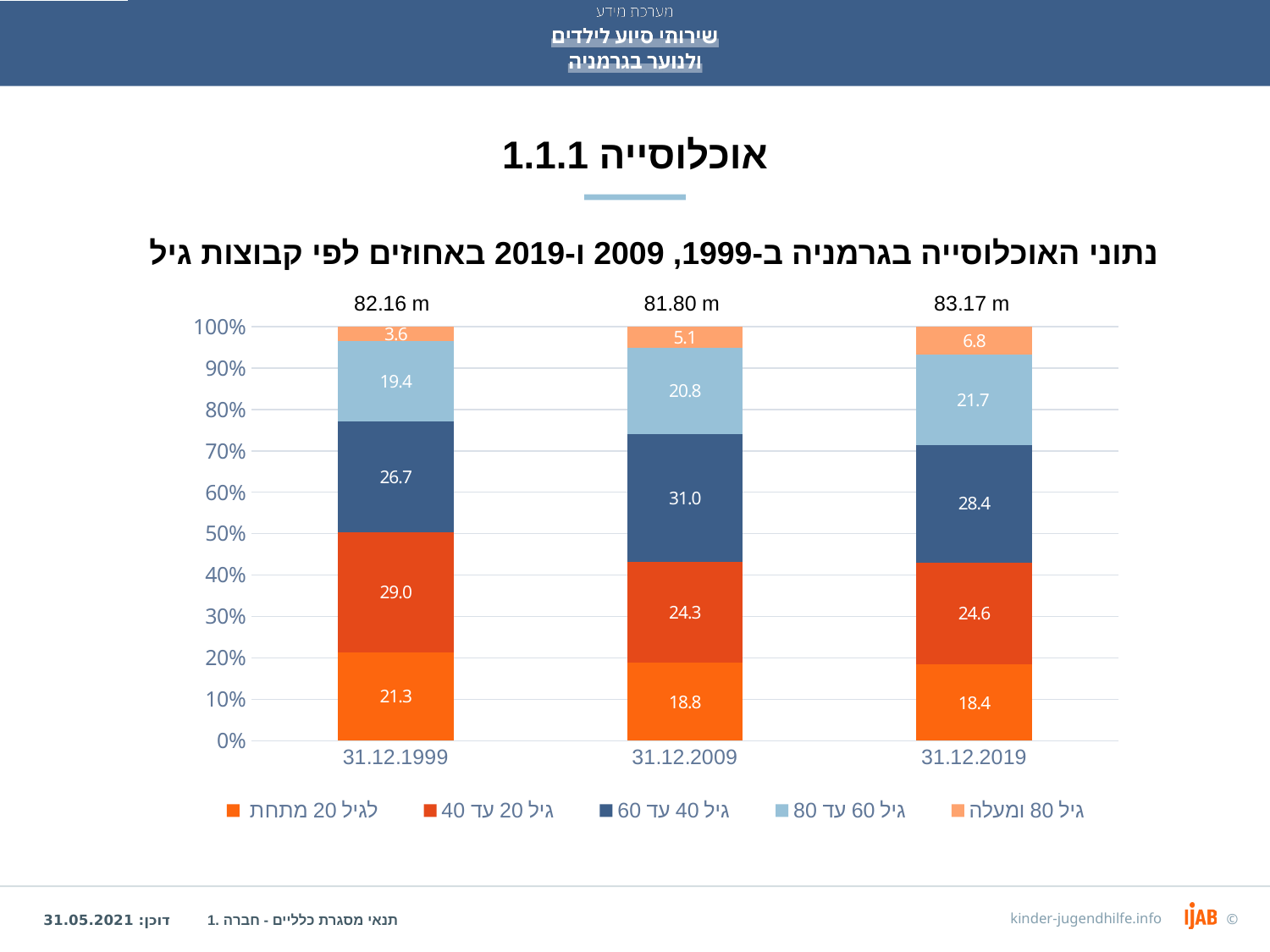
What total population figure is printed above the 31.12.2019 bar? 83.17 m Does the value for 'גיל 60 עד 80' rise or fall from 31.12.1999 to 31.12.2019? rise What is the value for the 'גיל 40 עד 60' series at 31.12.2009? 31.0 At which date is the value for 'גיל 80 ומעלה' the highest? 31.12.2019 What is the value for the 'מתחת לגיל 20' series at 31.12.1999? 21.3 How many dates (categories) are shown on the x axis? 3 How many series does the legend list? 5 What type of chart is shown on the slide? stacked bar chart What is the difference between the 'גיל 20 עד 40' values at 31.12.1999 and 31.12.2009? 4.7 What is the value for the 'גיל 80 ומעלה' series at 31.12.2019? 6.8 Which is larger at 31.12.2019: the value for 'גיל 40 עד 60' or the value for 'גיל 60 עד 80'? גיל 40 עד 60 At which date is the value for 'מתחת לגיל 20' the lowest? 31.12.2019